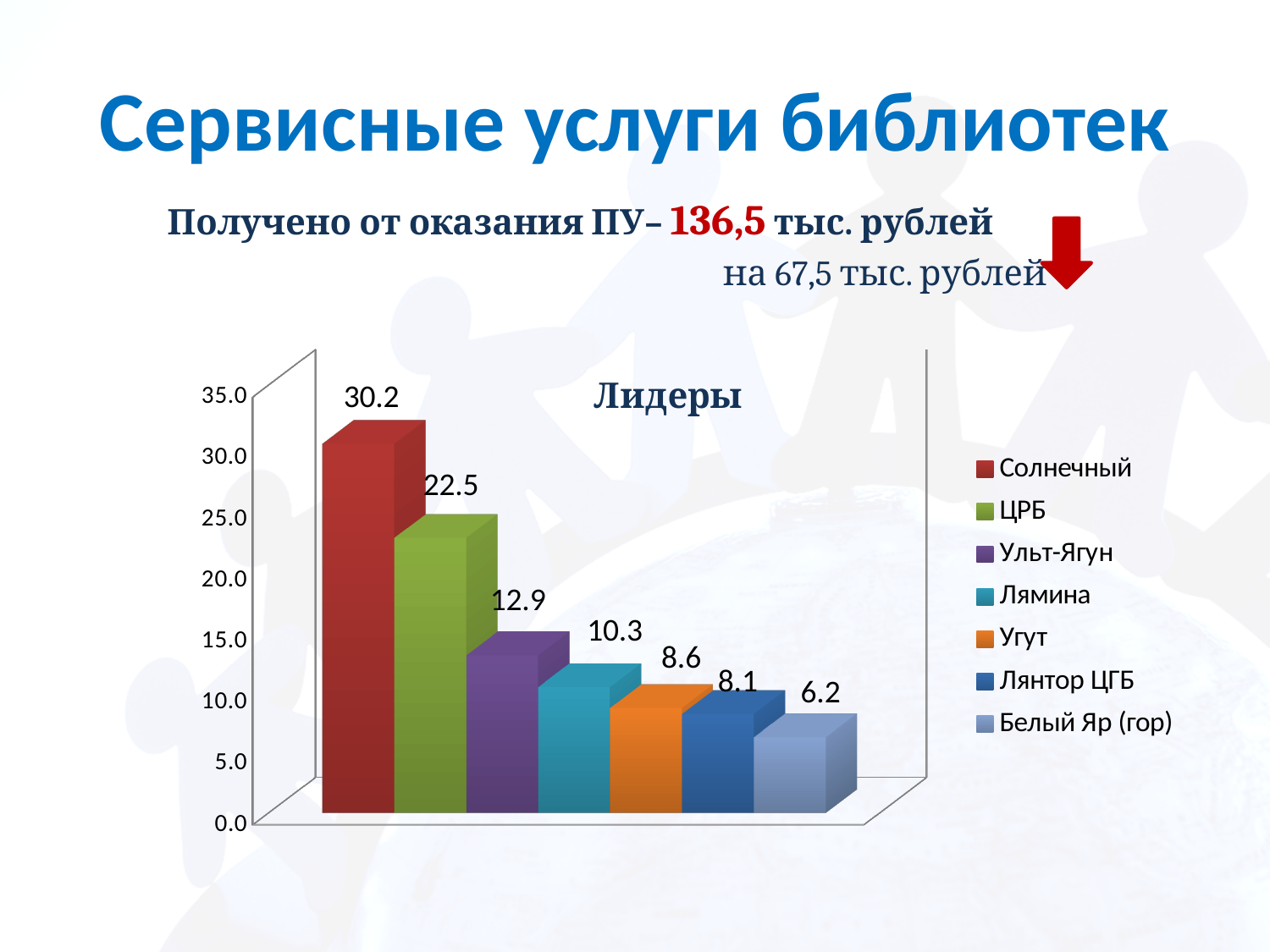
What is the value for Солнечный in the Лидеры chart? 30.2 What is the value for Белый Яр (гор) in the Лидеры chart? 6.2 How many entries does the legend of the Лидеры chart list? 7 What is the difference between the values for Солнечный and ЦРБ in the Лидеры chart? 7.7 What kind of chart is the Лидеры chart? bar chart Which is larger in the Лидеры chart, the value for Ульт-Ягун or the value for Угут? Ульт-Ягун Do the values in the Лидеры chart rise or fall from left to right? fall How many bars are shown in the Лидеры chart? 7 Which category has the highest value in the Лидеры chart? Солнечный What is the value for Лямина in the Лидеры chart? 10.3 What is the value for ЦРБ in the Лидеры chart? 22.5 Which category has the lowest value in the Лидеры chart? Белый Яр (гор)